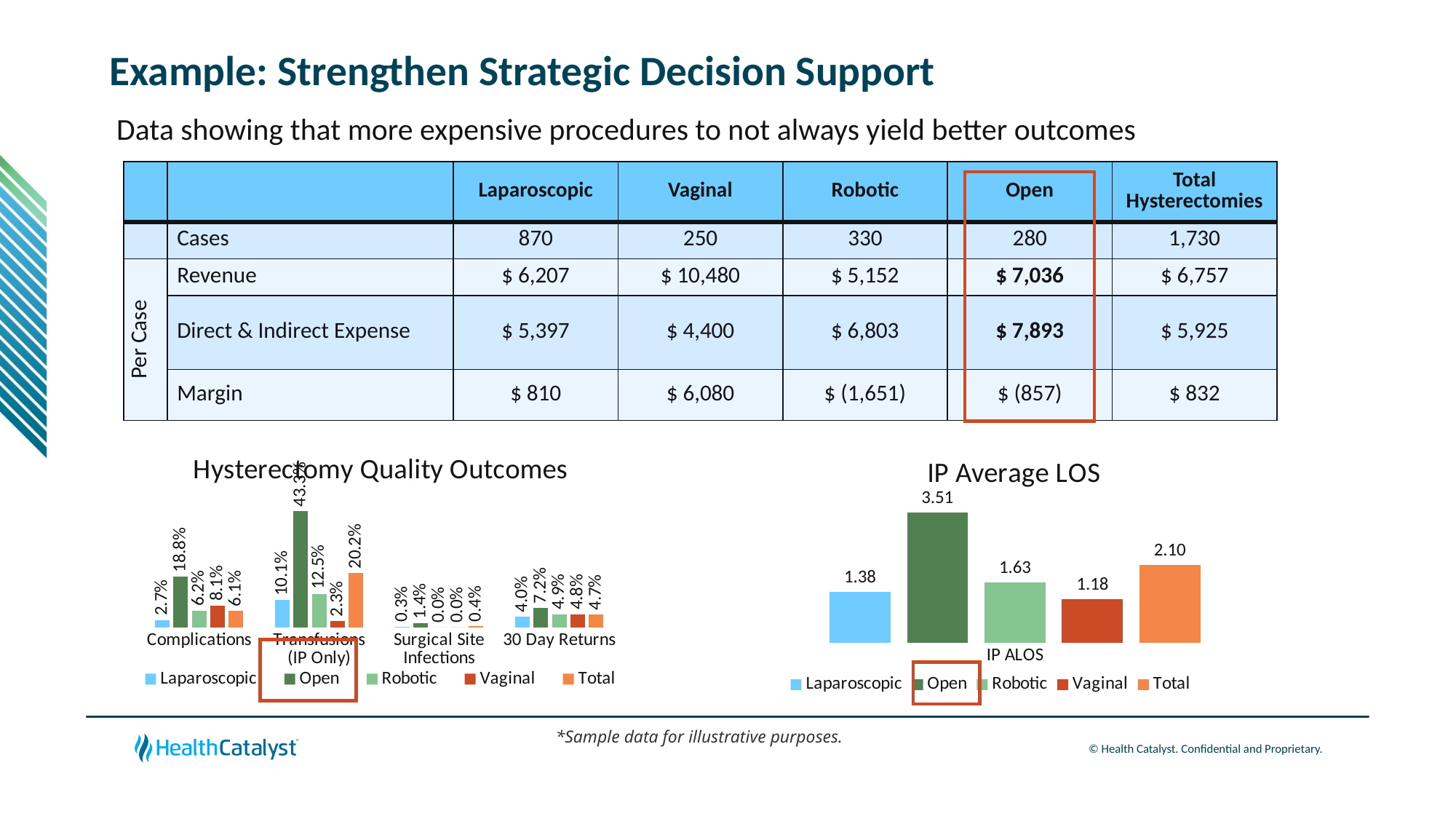
In the Hysterectomy Quality Outcomes chart, what is the Open value for Transfusions (IP Only)? 43.3% In the Hysterectomy Quality Outcomes chart, what is the Vaginal value for Complications? 8.1% In the IP Average LOS chart, what is the difference between the Open and Laparoscopic values? 2.13 What kind of chart is the IP Average LOS chart? Bar chart In the Hysterectomy Quality Outcomes chart, which series has the highest value for Complications? Open In the IP Average LOS chart, what is the value for Open? 3.51 In the IP Average LOS chart, which series has the lowest value? Vaginal In the IP Average LOS chart, how many series does the legend list? 5 In the Hysterectomy Quality Outcomes chart, how many categories are shown on the x axis? 4 In the Hysterectomy Quality Outcomes chart, which series has the lowest value for Transfusions (IP Only)? Vaginal In the Hysterectomy Quality Outcomes chart, is the Total value for Transfusions (IP Only) larger or smaller than the Robotic value? Larger In the Hysterectomy Quality Outcomes chart, what is the difference between the Open and Laparoscopic values for 30 Day Returns? 3.2%